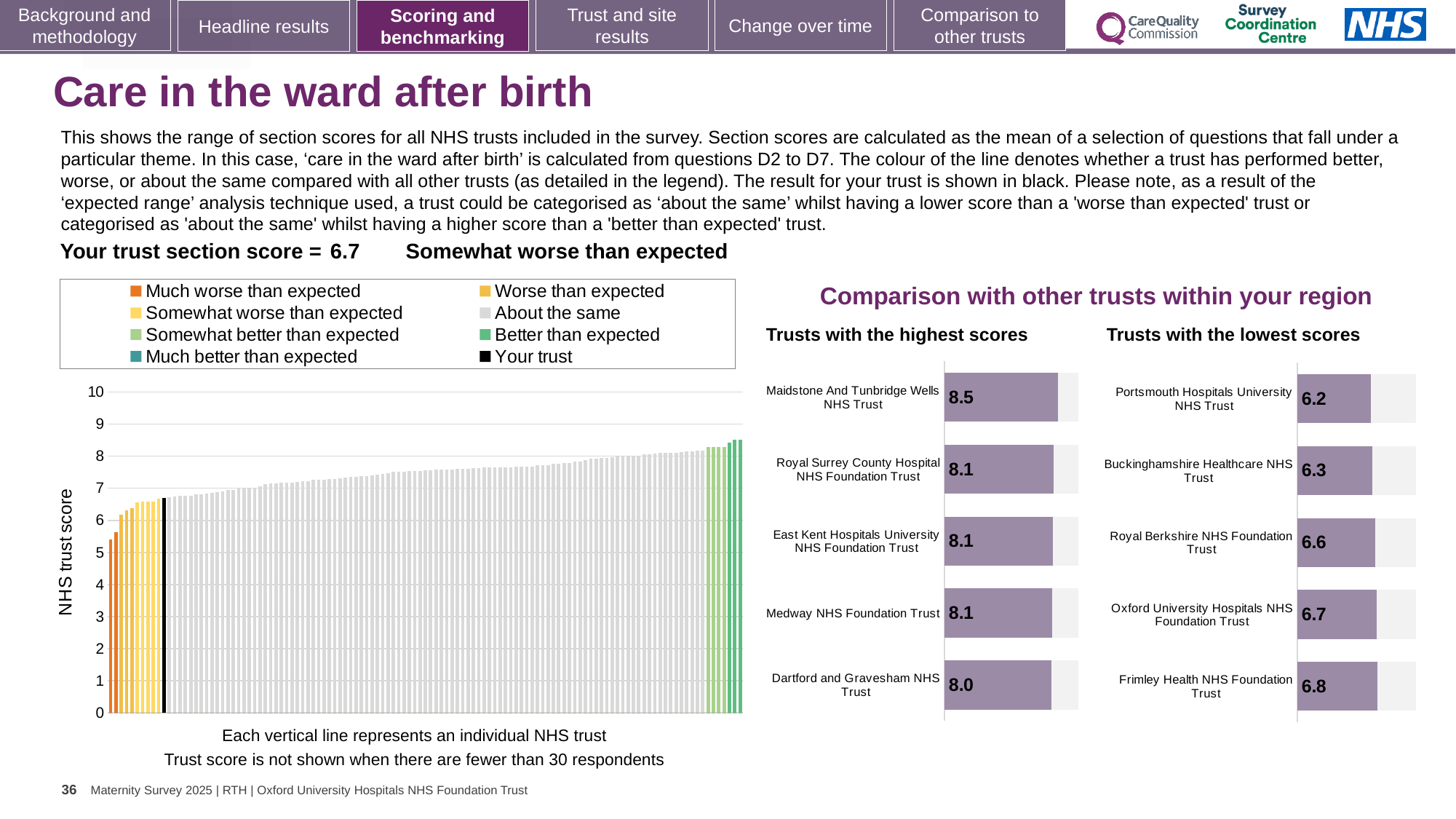
In the 'NHS trust score' chart on the left, what is the section score for your trust (the black bar)? 6.7 How many trusts are shown in the 'Trusts with the highest scores' chart? 5 In the 'NHS trust score' chart on the left, do the values rise or fall from left to right? rise In the 'Trusts with the highest scores' chart, what is the difference between the scores of Maidstone And Tunbridge Wells NHS Trust and Dartford and Gravesham NHS Trust? 0.5 In the 'Trusts with the lowest scores' chart, what is the score for Portsmouth Hospitals University NHS Trust? 6.2 In the 'Trusts with the lowest scores' chart, which trust has the lowest score? Portsmouth Hospitals University NHS Trust What kind of chart is the 'NHS trust score' chart on the left of the slide? bar chart In the 'Trusts with the highest scores' chart, what is the score for Maidstone And Tunbridge Wells NHS Trust? 8.5 In the 'Trusts with the highest scores' chart, which trust has the highest score? Maidstone And Tunbridge Wells NHS Trust In the 'Trusts with the lowest scores' chart, which has the higher score: Royal Berkshire NHS Foundation Trust or Buckinghamshire Healthcare NHS Trust? Royal Berkshire NHS Foundation Trust In the 'Trusts with the lowest scores' chart, what is the difference between the scores of Frimley Health NHS Foundation Trust and Portsmouth Hospitals University NHS Trust? 0.6 How many entries does the legend of the 'NHS trust score' chart on the left list? 8